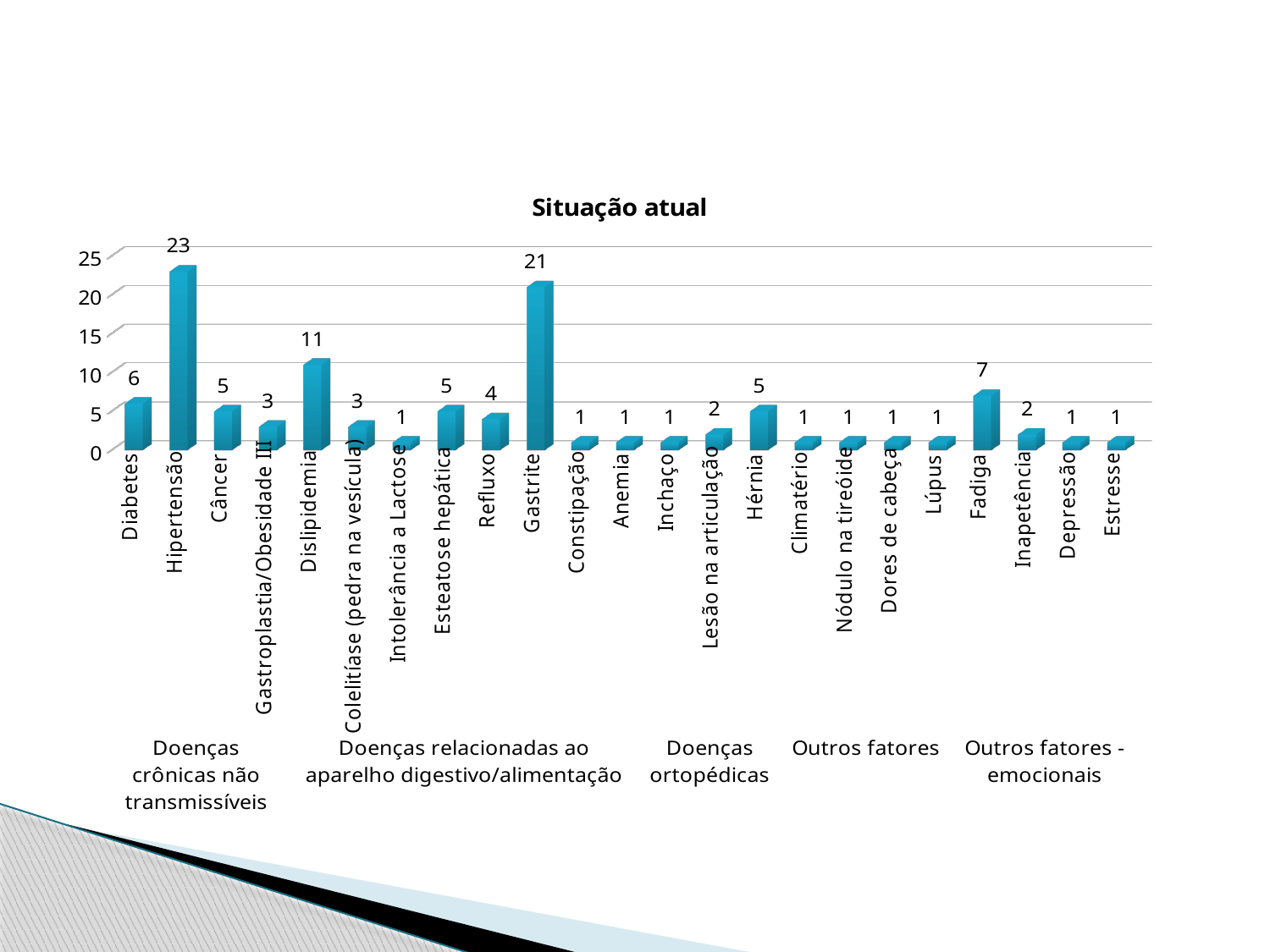
What is the title of the chart? Situação atual Which is larger, the value for Fadiga or the value for Hérnia? Fadiga What kind of chart is shown on the slide? Bar chart What is the value for Gastrite? 21 What is the value for Fadiga? 7 What is the value for Hipertensão? 23 What is the value for Dislipidemia? 11 Is the value for Hipertensão greater or less than 20? greater Which is larger, the value for Esteatose hepática or the value for Refluxo? Esteatose hepática What is the difference between the values for Hipertensão and Gastrite? 2 Which category has the highest value? Hipertensão What is the difference between the values for Dislipidemia and Diabetes? 5